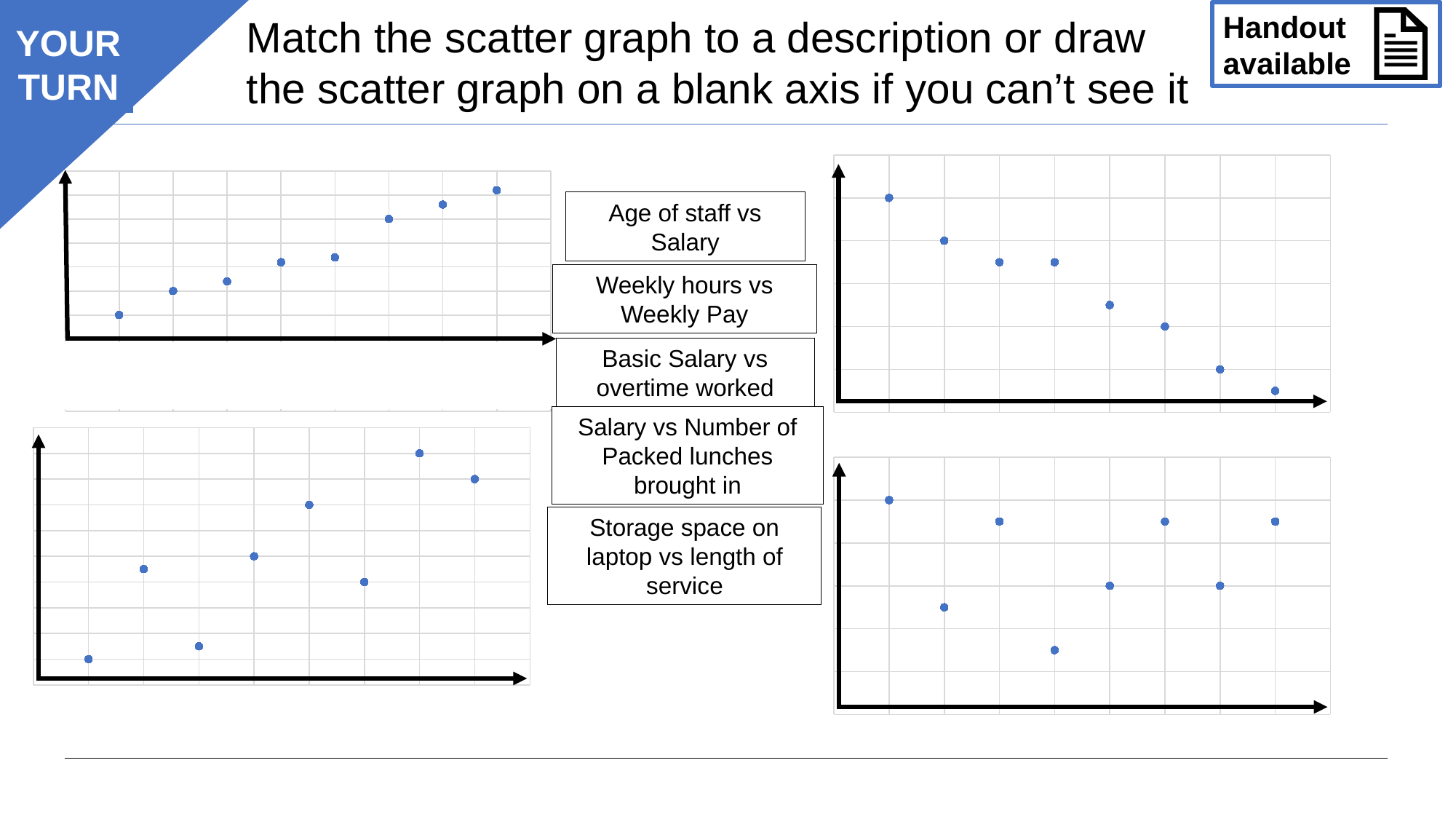
On the top-right chart, do the points rise or fall as you move along the x axis? fall What kind of chart is the top-right chart? scatter chart How many points are plotted on the bottom-right chart? 8 What kind of chart is the top-left chart? scatter chart How many points are plotted on the bottom-left chart? 8 How many points are plotted on the top-right chart? 8 How many description boxes are there to match to the scatter graphs? 5 On the bottom-right chart, do the points show a clear rise or fall along the x axis? no clear trend On the top-left chart, do the points rise or fall as you move along the x axis? rise How many scatter charts are shown on the slide? 4